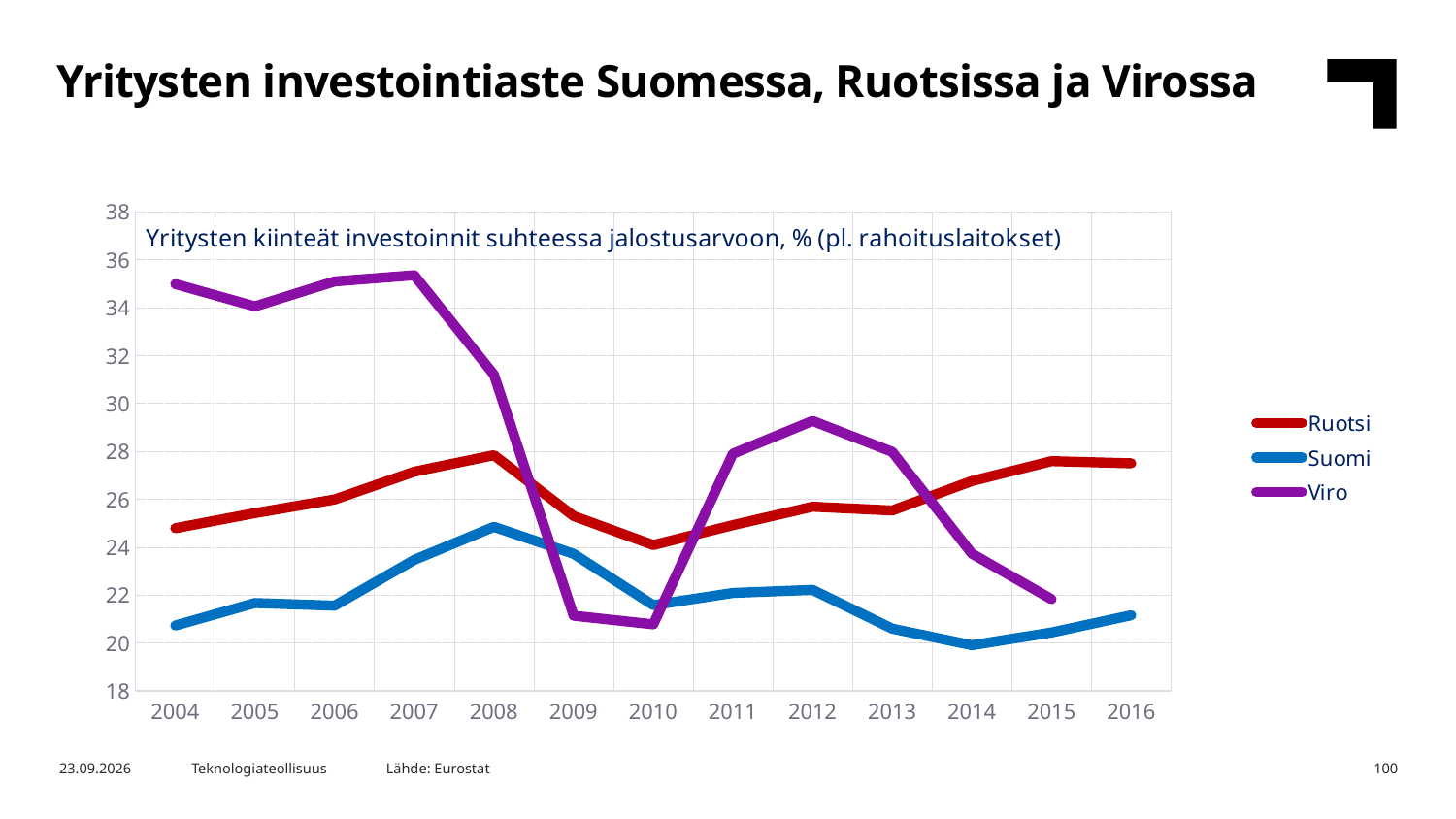
In which year does the Suomi line reach its lowest value? 2014 Is the value for Viro in 2004 greater or less than 30? greater How many series does the legend list? 3 Is the value for Viro in 2010 greater or less than 22? less How many years are shown on the x axis? 13 Does the Viro line rise or fall from 2012 to 2015? fall Is the value for Ruotsi in 2015 greater or less than 26? greater Which series is drawn in red? Ruotsi Which series has the lowest value in 2014? Suomi Which is larger in 2012, the value for Viro or the value for Ruotsi? Viro What kind of chart is shown on the slide? line chart Which series has the highest value in 2007? Viro